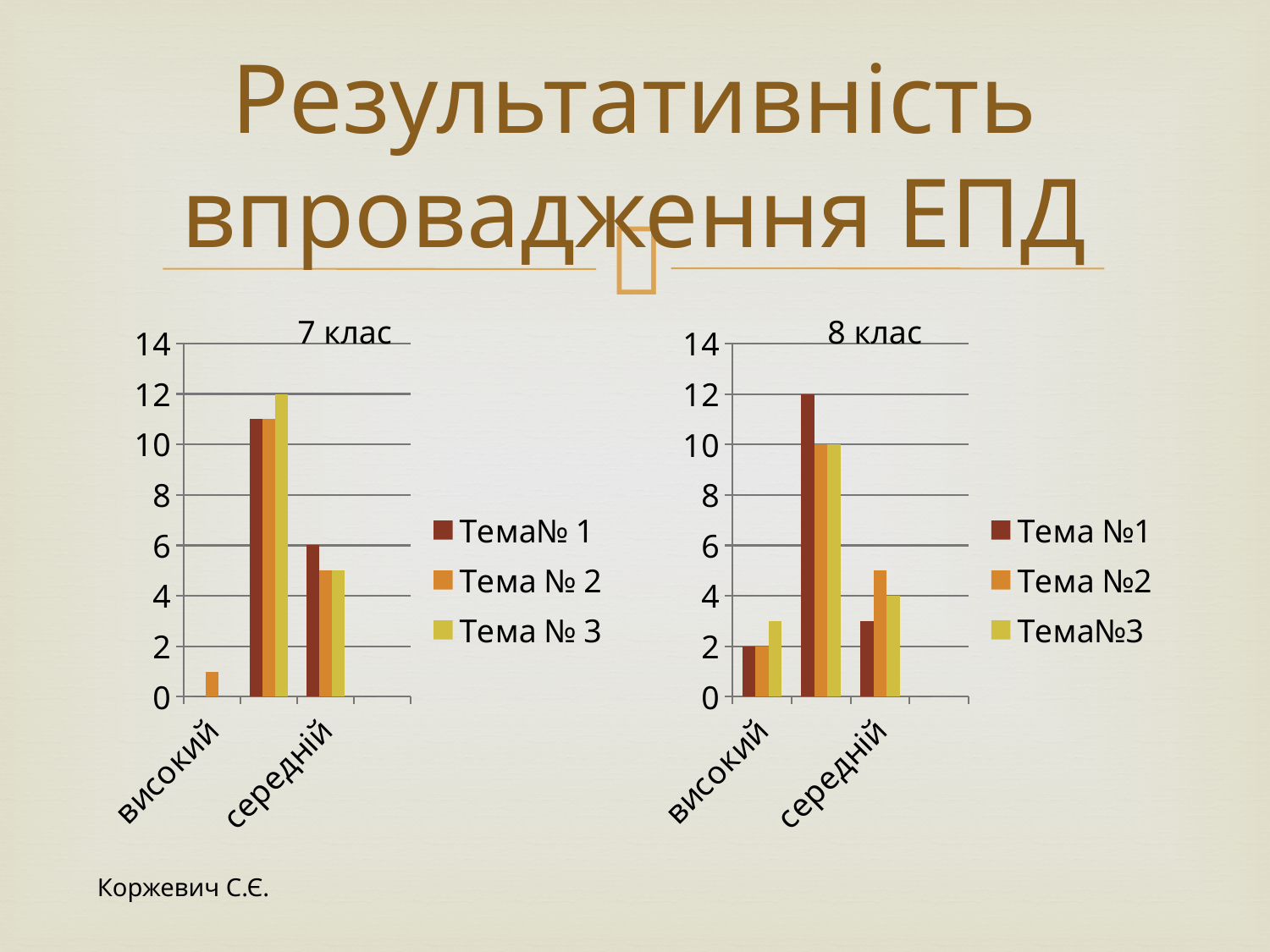
In the "7 клас" chart, is the value for Тема № 2 in the "високий" category greater or less than 2? less In the "7 клас" chart, which series has the highest value in the "середній" category? Тема№ 1 In the "8 клас" chart, which series has the lowest value in the "середній" category? Тема №1 In the "8 клас" chart, what is the value for Тема №1 in the "високий" category? 2 What are the legend entries of the "8 клас" chart? Тема №1, Тема №2, Тема№3 In the "8 клас" chart, what is the value for Тема№3 in the "середній" category? 4 In the "8 клас" chart, is the value for Тема №2 in the "середній" category greater or less than 4? greater How many series does the legend of the "7 клас" chart list? 3 What kind of chart is the "7 клас" chart? bar chart In the "8 клас" chart, which series has the highest value in the "середній" category? Тема №2 What is the title of the chart on the left side of the slide? 7 клас In the "7 клас" chart, what is the value for Тема№ 1 in the "середній" category? 6